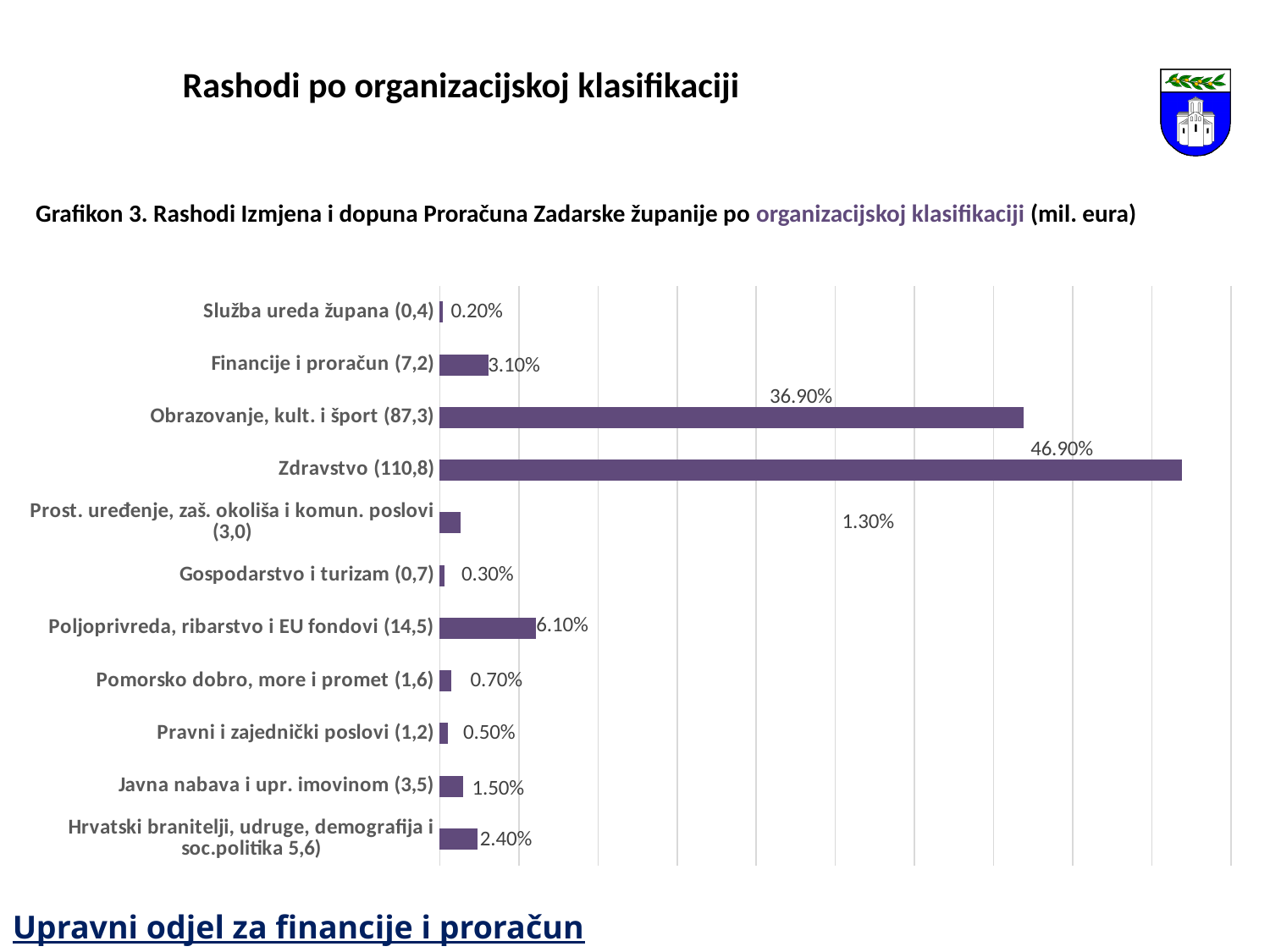
Which category has the highest value? Zdravstvo (110,8) What is the value shown for Obrazovanje, kult. i šport (87,3)? 36.90% What kind of chart is shown on the slide? bar chart What is the value shown for Poljoprivreda, ribarstvo i EU fondovi (14,5)? 6.10% Which category has the lowest value? Služba ureda župana (0,4) What is the value shown for Zdravstvo (110,8)? 46.90% What is the value shown for Javna nabava i upr. imovinom (3,5)? 1.50% What is the difference between the values for Poljoprivreda, ribarstvo i EU fondovi (14,5) and Financije i proračun (7,2)? 3.00% Which is larger, the value for Financije i proračun (7,2) or the value for Hrvatski branitelji, udruge, demografija i soc.politika 5,6)? Financije i proračun (7,2) What is the difference between the values for Zdravstvo (110,8) and Obrazovanje, kult. i šport (87,3)? 10.00% How many categories are shown in the chart? 11 What is the title of the chart (Grafikon 3)? Rashodi Izmjena i dopuna Proračuna Zadarske županije po organizacijskoj klasifikaciji (mil. eura)